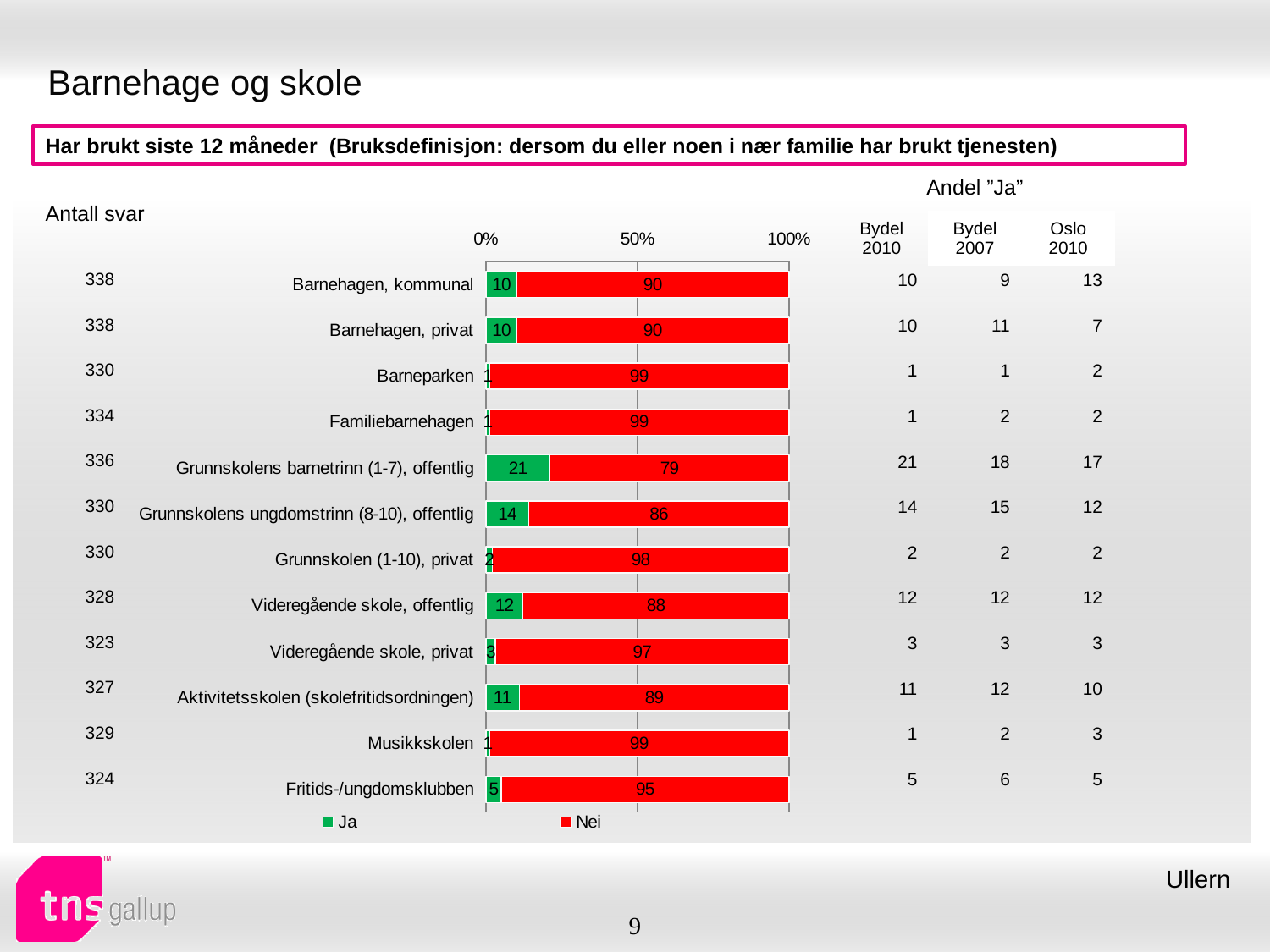
What is the difference between the "Ja" values for Grunnskolens barnetrinn (1-7), offentlig and Grunnskolens ungdomstrinn (8-10), offentlig? 7 Which category has the lowest "Nei" value? Grunnskolens barnetrinn (1-7), offentlig Which has a larger "Ja" value: Videregående skole, offentlig or Aktivitetsskolen (skolefritidsordningen)? Videregående skole, offentlig How many categories are shown in the bar chart? 12 What is the "Ja" value for Grunnskolens barnetrinn (1-7), offentlig? 21 How many series does the chart legend list? 2 What are the two series named in the chart legend? Ja and Nei What kind of chart is shown on the slide? Stacked bar chart Which category has the highest "Ja" value? Grunnskolens barnetrinn (1-7), offentlig Is the "Nei" value for Barneparken greater or less than 50%? greater What is the "Nei" value for Videregående skole, offentlig? 88 What is the "Ja" value for Fritids-/ungdomsklubben? 5